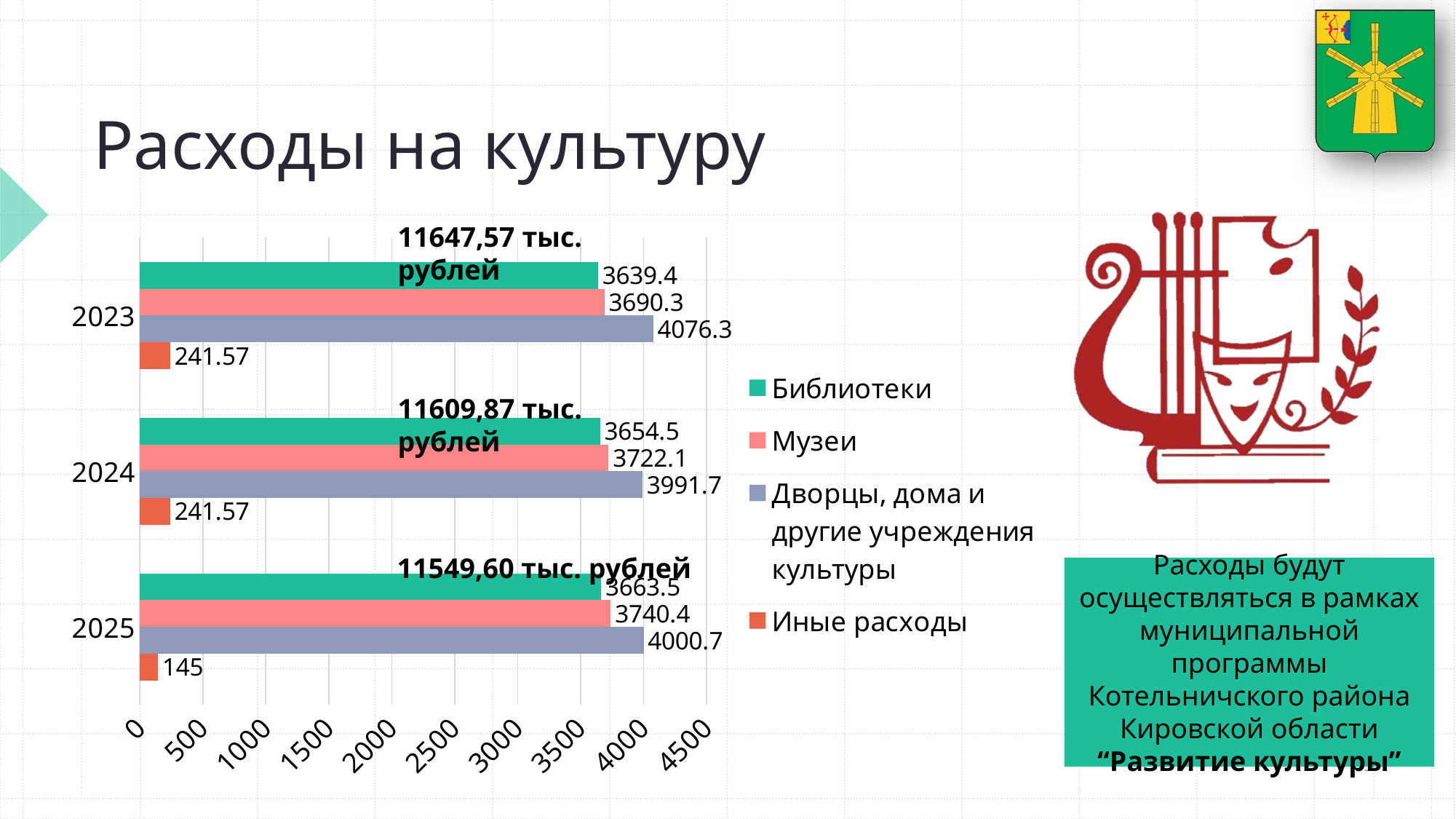
What is the value for Музеи in 2024? 3722.1 How many years are shown on the chart? 3 What is the value for Дворцы, дома и другие учреждения культуры in 2025? 4000.7 Which series has the lowest value in 2024? Иные расходы Which series has the highest value in 2023? Дворцы, дома и другие учреждения культуры What is the difference between Дворцы, дома и другие учреждения культуры and Библиотеки in 2024? 337.2 What kind of chart is shown on the slide? bar chart What is the value for Иные расходы in 2025? 145 Which is larger: Музеи in 2023 or Музеи in 2025? Музеи in 2025 Is the value for Дворцы, дома и другие учреждения культуры in 2023 greater or less than 4000? greater What is the value for Библиотеки in 2023? 3639.4 How many series does the legend list? 4